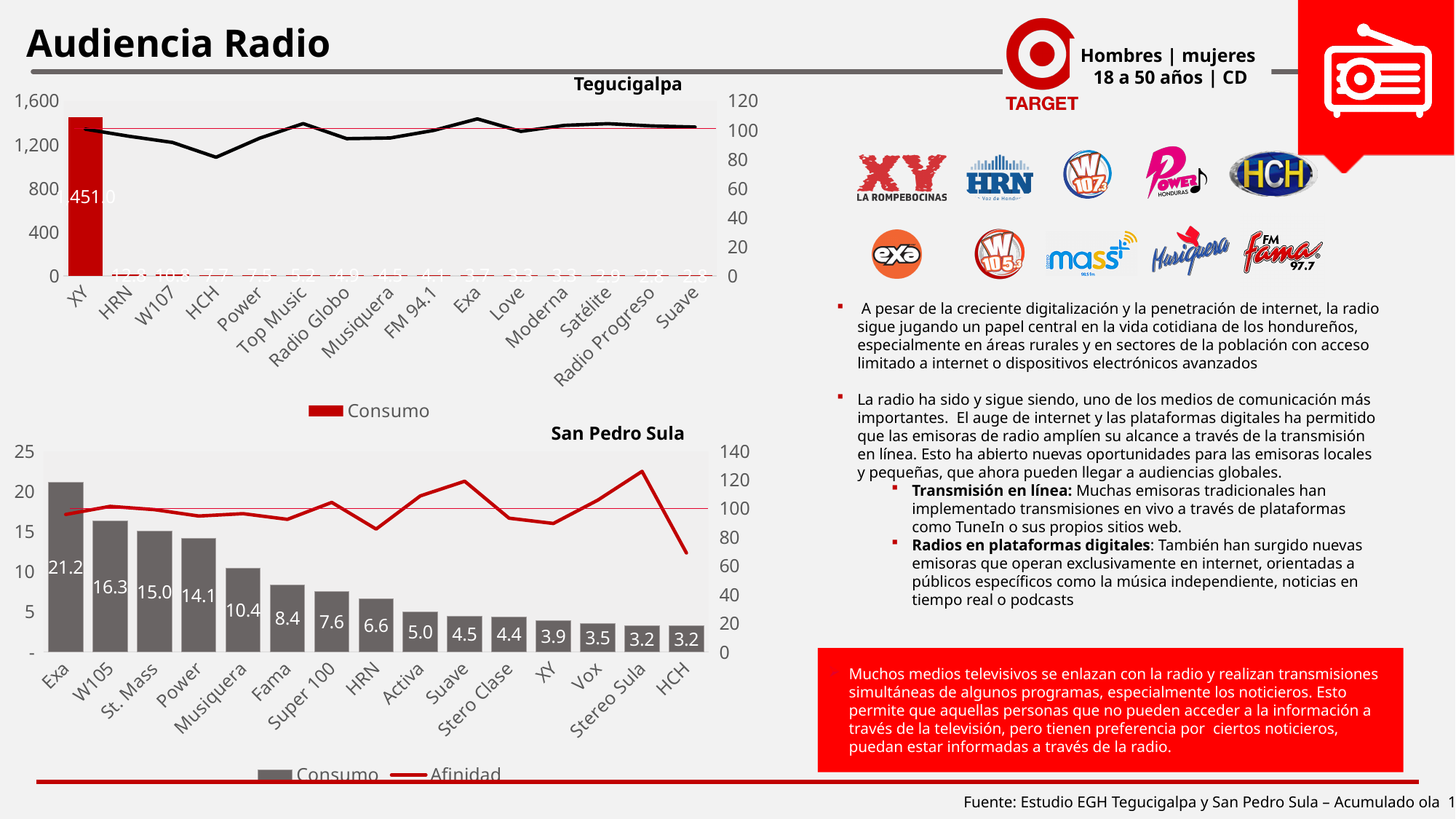
In the San Pedro Sula chart, what is the difference between the Consumo values for Exa and W105? 4.9 In the San Pedro Sula chart, what is the Consumo value for Exa? 21.2 In the San Pedro Sula chart, which station has the highest Consumo bar? Exa In the San Pedro Sula chart, is the Afinidad value for HCH greater or less than 80? less In the San Pedro Sula chart, is the Afinidad value for Stereo Sula greater or less than 100? greater What kind of chart is the San Pedro Sula chart? bar chart with a line In the San Pedro Sula chart, which has a higher Consumo value, Power or Fama? Power How many series does the legend of the San Pedro Sula chart list? 2 In the San Pedro Sula chart, what is the Consumo value for Musiquera? 10.4 In the Tegucigalpa chart, what is the Consumo value labelled on the XY bar? 1,451.0 In the San Pedro Sula chart, how many stations are shown on the x axis? 15 In the Tegucigalpa chart, which station has the highest Consumo bar? XY